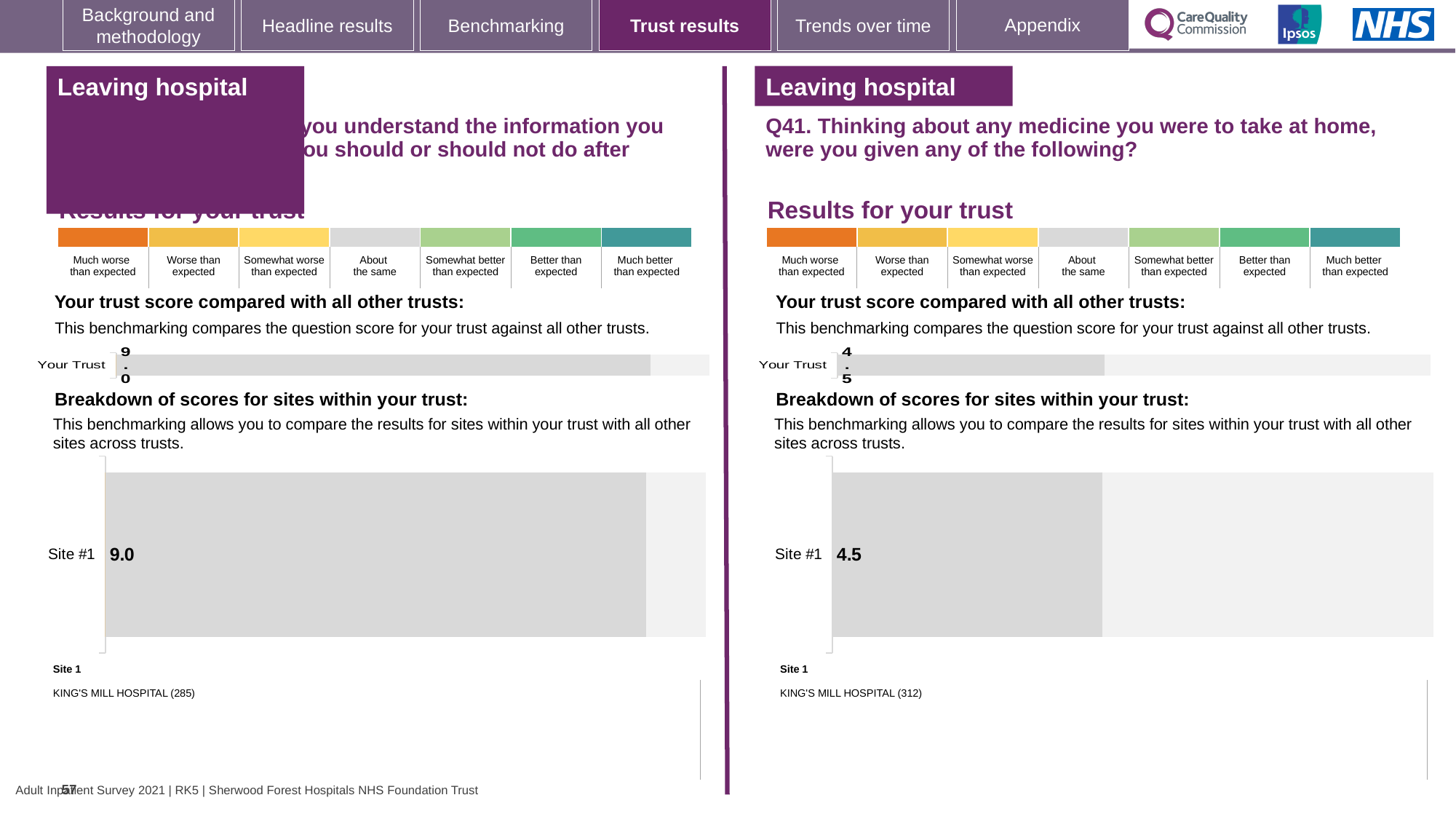
Which is larger: the Site #1 score on the left panel or the Site #1 score on the right panel (Q41)? Left panel (9.0) What type of chart is used to show the Site #1 score on the left panel? Bar chart How many sites are shown in the breakdown of scores chart on the left panel? 1 On the left panel, what is the score shown for Your Trust in the trust score comparison bar? 9.0 On the right panel (Q41), what is the score shown for Your Trust in the trust score comparison bar? 4.5 What is the difference between the Site #1 score on the left panel (9.0) and the Site #1 score on the right panel (4.5)? 4.5 Which hospital is listed as Site 1 on the right panel (Q41)? KING'S MILL HOSPITAL (312) How many sites are shown in the breakdown of scores chart on the right panel (Q41)? 1 On the right panel (Q41), what is the score shown for Site #1 in the breakdown of scores for sites within your trust? 4.5 Which hospital is listed as Site 1 on the left panel? KING'S MILL HOSPITAL (285) On the left panel, what is the score shown for Site #1 in the breakdown of scores for sites within your trust? 9.0